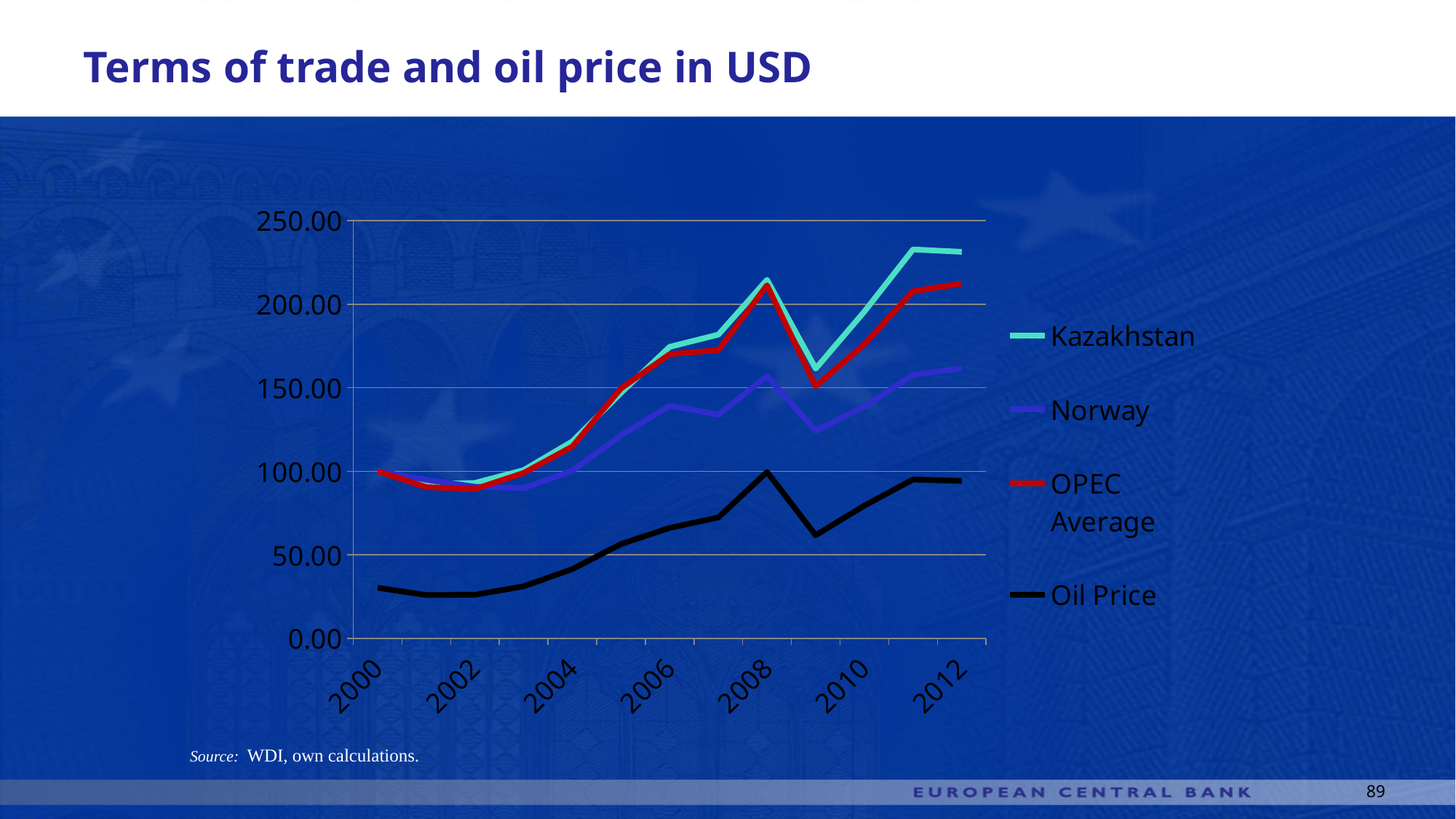
What kind of chart is shown on the slide? line chart Which is larger in 2006, the value for Norway or the value for Oil Price? Norway What is the title of the slide's chart? Terms of trade and oil price in USD Is the value for Norway in 2009 greater or less than 150? less Which series has the lowest value in 2012? Oil Price How many year labels are shown on the x axis? 7 Is the value for Oil Price in 2000 greater or less than 50? less Is the value for Kazakhstan in 2012 greater or less than 200? greater How many series does the legend list? 4 Does the Oil Price series rise or fall between 2000 and 2008? rise Which series has the highest value in 2012? Kazakhstan What colour is the Oil Price line in the chart? black